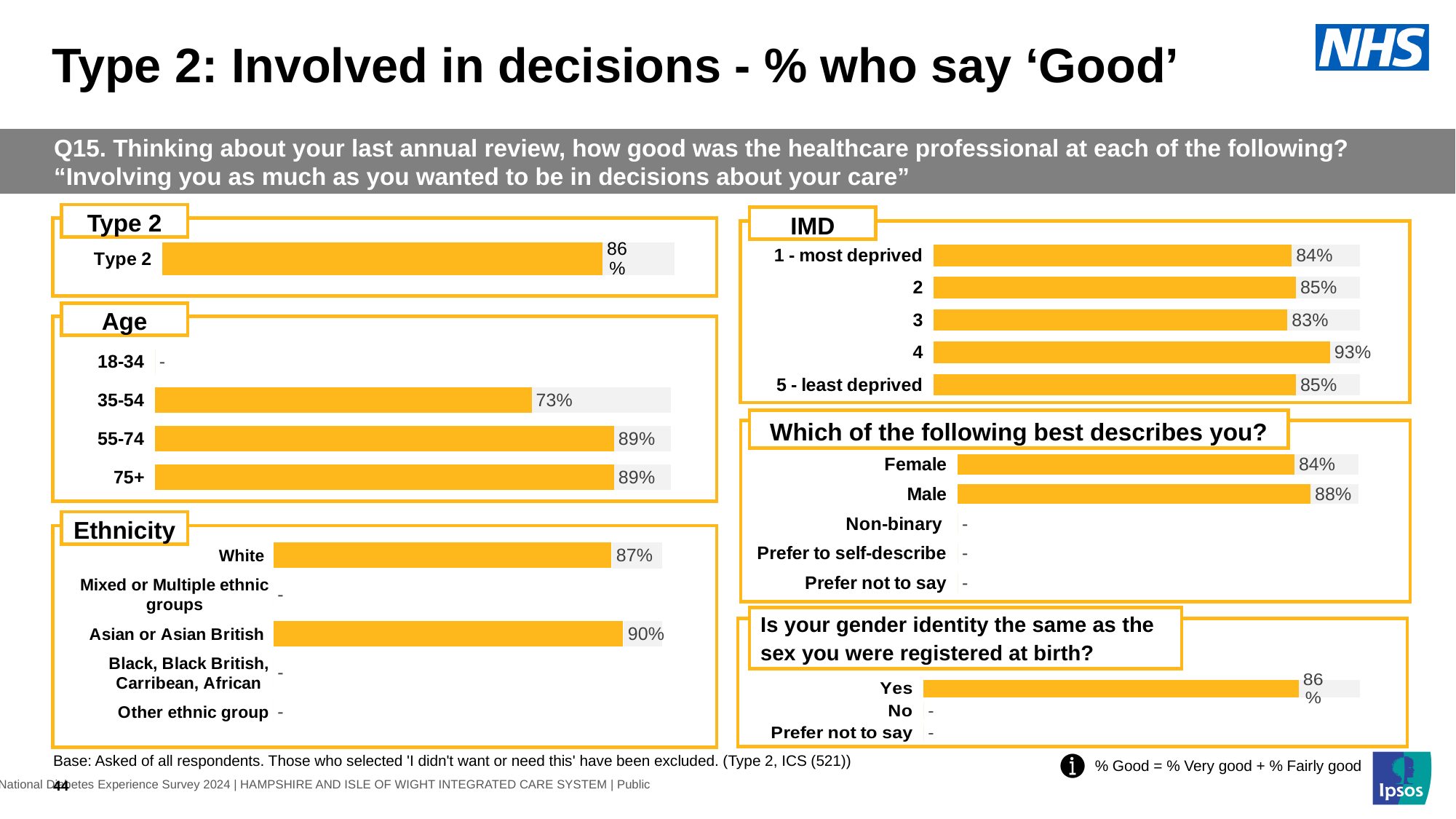
In the 'Which of the following best describes you?' chart, what is the value for Male? 88% In the Age chart, which age group with a printed value has the lowest percentage? 35-54 In the Type 2 chart, what percentage of Type 2 respondents say 'Good'? 86% In the IMD chart, which deprivation group has the highest percentage? 4 In the IMD chart, what is the value for 3? 83% In the Ethnicity chart, what is the value for Asian or Asian British? 90% In the IMD chart, what is the difference between group 4 and 1 - most deprived? 9 percentage points What type of chart is used in the IMD section? Bar chart In the Ethnicity chart, which is larger, the value for White or for Asian or Asian British? Asian or Asian British In the 'Is your gender identity the same as the sex you were registered at birth?' chart, what is the value for Yes? 86% In the Age chart, what is the value for the 35-54 age group? 73% In the Age chart, what is the difference between the 55-74 and 35-54 values? 16 percentage points